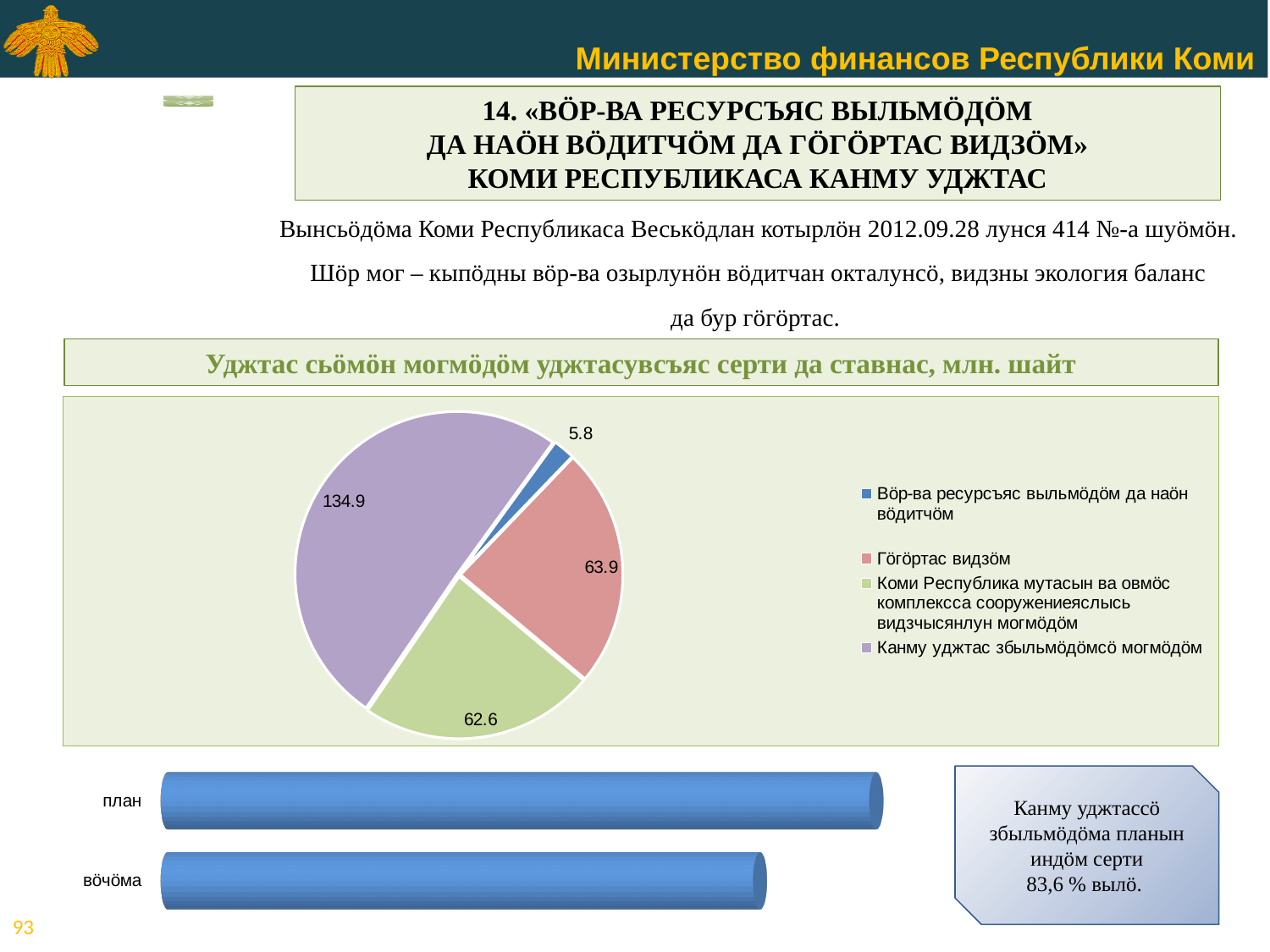
How many slices does the pie chart have? 4 How many entries does the legend of the pie chart list? 4 What kind of chart is the upper chart on the slide? pie chart In the lower bar chart, which bar is longer: «план» or «вöчöма»? план In the pie chart, which category has the smallest slice? Вöр-ва ресурсъяс выльмöдöм да наöн вöдитчöм In the pie chart, what is the value for the slice labelled «Гöгöртас видзöм»? 63.9 What kind of chart is the lower chart on the slide, with the categories «план» and «вöчöма»? bar chart In the pie chart, what is the value for «Вöр-ва ресурсъяс выльмöдöм да наöн вöдитчöм»? 5.8 In the pie chart, what is the value for «Канму уджтас збыльмöдöмсö могмöдöм»? 134.9 In the pie chart, which is larger: the value for «Гöгöртас видзöм» or the value for «Коми Республика мутасын ва овмöс комплексса сооружениеяслысь видзчысянлун могмöдöм»? Гöгöртас видзöм In the pie chart, what is the difference between the largest value (134.9) and the smallest value (5.8)? 129.1 In the pie chart, which category has the largest slice? Канму уджтас збыльмöдöмсö могмöдöм